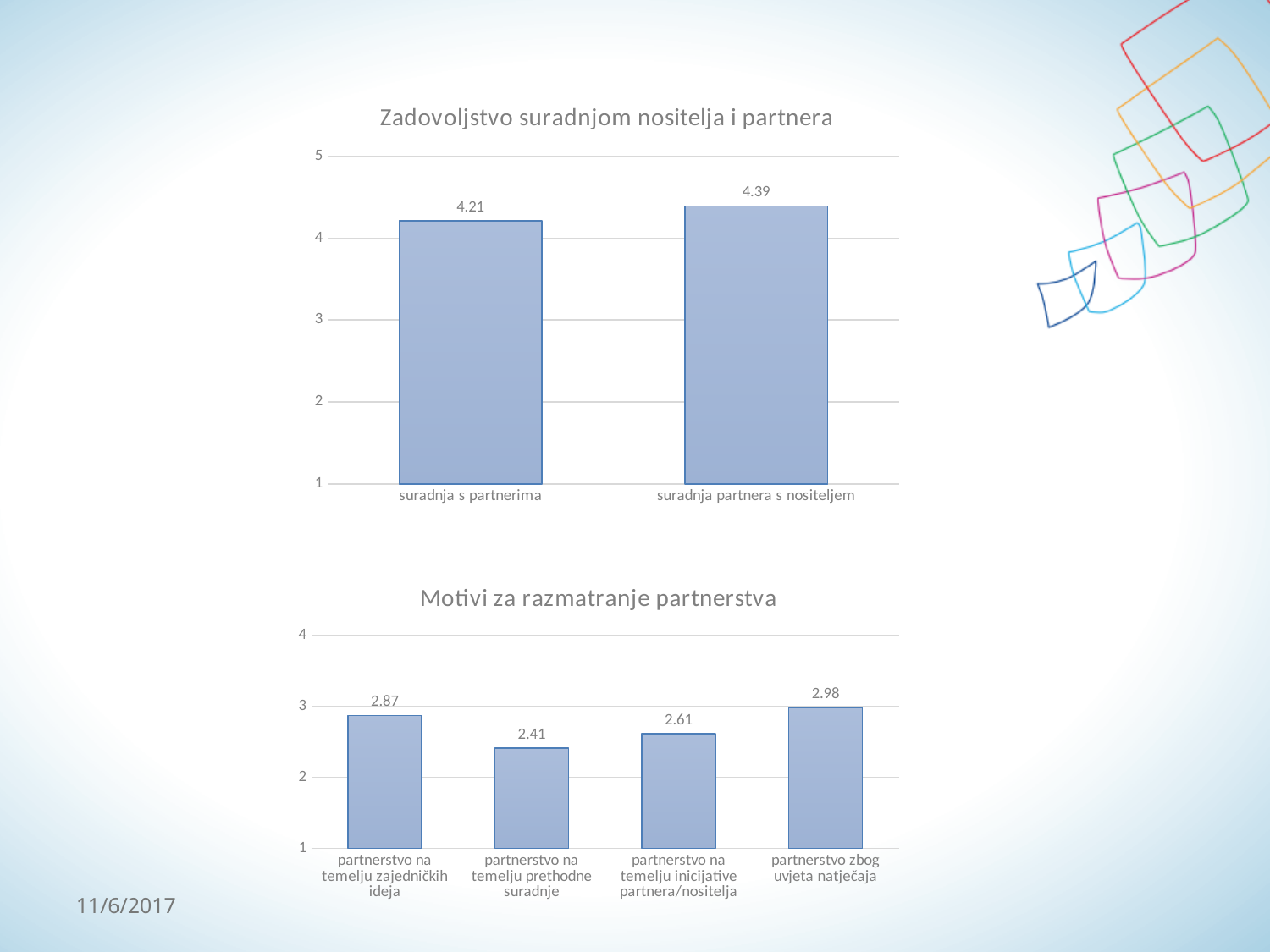
In the chart titled "Zadovoljstvo suradnjom nositelja i partnera", how many categories are shown? 2 In the chart titled "Zadovoljstvo suradnjom nositelja i partnera", what is the value for "suradnja partnera s nositeljem"? 4.39 In the chart titled "Motivi za razmatranje partnerstva", what is the difference between the values for "partnerstvo zbog uvjeta natječaja" and "partnerstvo na temelju prethodne suradnje"? 0.57 What kind of chart is the bottom chart on the slide? bar chart In the chart titled "Zadovoljstvo suradnjom nositelja i partnera", which category has the higher value? suradnja partnera s nositeljem In the chart titled "Motivi za razmatranje partnerstva", which category has the highest value? partnerstvo zbog uvjeta natječaja In the chart titled "Motivi za razmatranje partnerstva", which category has the lowest value? partnerstvo na temelju prethodne suradnje In the chart titled "Motivi za razmatranje partnerstva", what is the value for "partnerstvo na temelju prethodne suradnje"? 2.41 In the chart titled "Motivi za razmatranje partnerstva", what is the value for "partnerstvo zbog uvjeta natječaja"? 2.98 In the chart titled "Motivi za razmatranje partnerstva", which is larger: the value for "partnerstvo na temelju zajedničkih ideja" or for "partnerstvo na temelju inicijative partnera/nositelja"? partnerstvo na temelju zajedničkih ideja In the chart titled "Zadovoljstvo suradnjom nositelja i partnera", what is the difference between the two values? 0.18 In the chart titled "Zadovoljstvo suradnjom nositelja i partnera", what is the value for "suradnja s partnerima"? 4.21